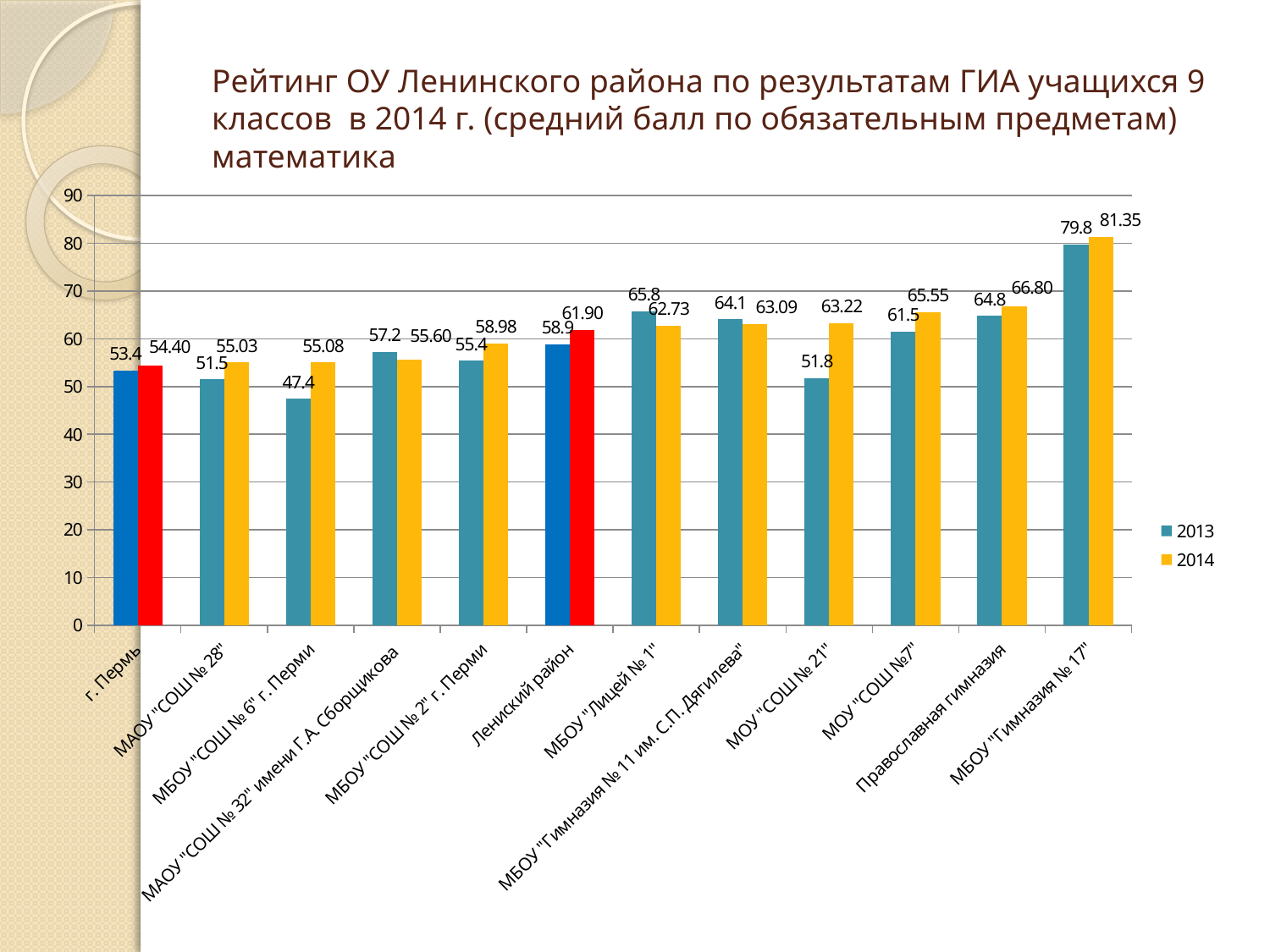
What is the 2013 value for МОУ "СОШ № 21"? 51.8 What is the 2014 value for МБОУ "Гимназия № 17"? 81.35 Which category has the highest 2014 value? МБОУ "Гимназия № 17" How many series does the legend list? 2 What is the 2014 value for Ленинский район? 61.90 What are the two series named in the legend? 2013 and 2014 Which is larger for МБОУ "Лицей № 1": the 2013 value or the 2014 value? 2013 What is the 2013 value for МБОУ "СОШ № 6" г. Перми? 47.4 How many categories are shown on the x axis? 12 What kind of chart is shown on the slide? Bar chart What is the difference between the 2014 and 2013 values for МОУ "СОШ № 21"? 11.42 Which category has the lowest 2013 value? МБОУ "СОШ № 6" г. Перми